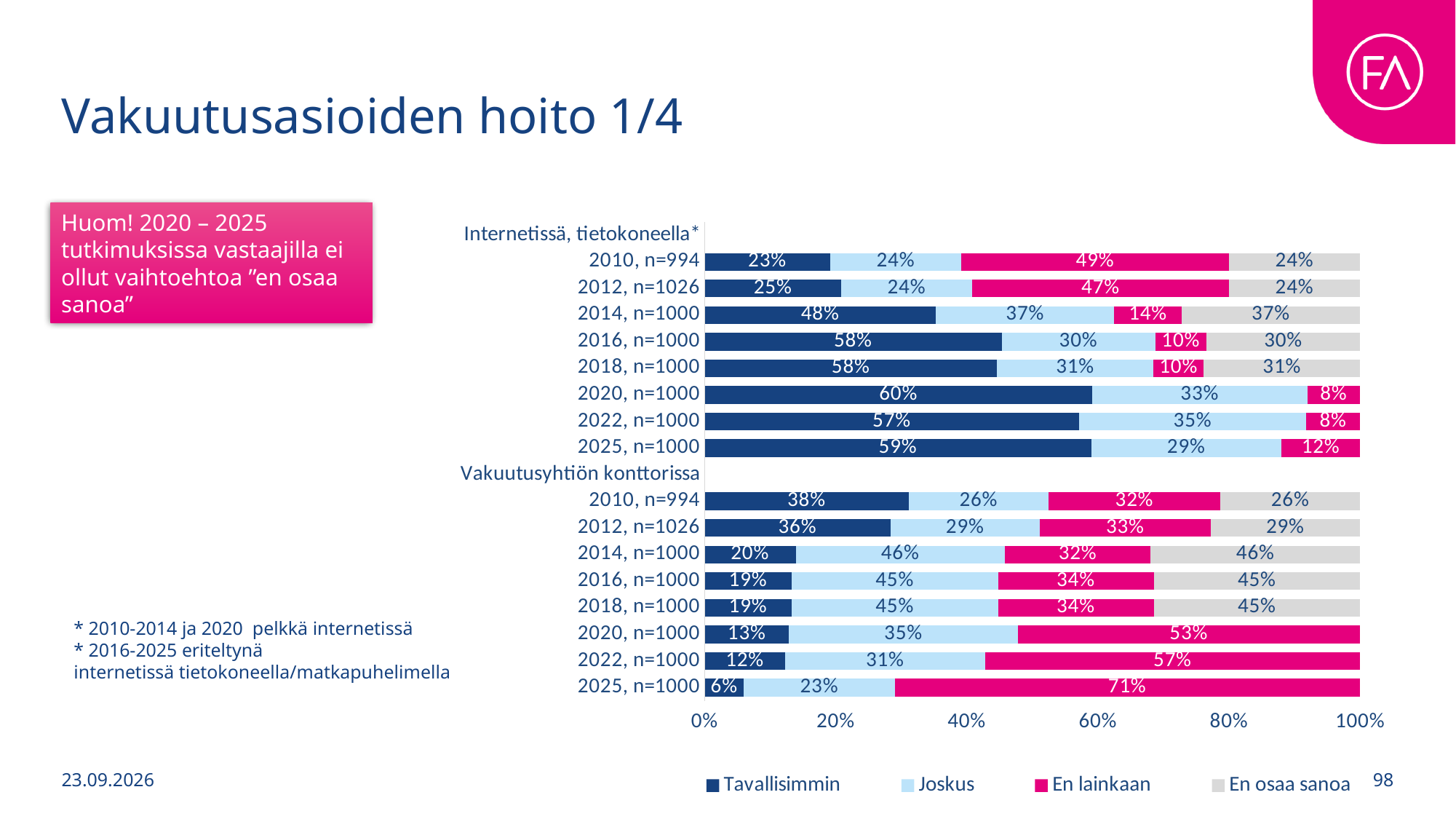
In the 'Vakuutusyhtiön konttorissa' group, which year has the highest 'En lainkaan' value? 2025, n=1000 In the 'Vakuutusyhtiön konttorissa' group, what is the 'Joskus' value for 2014, n=1000? 46% How many year rows are shown under the 'Internetissä, tietokoneella' group? 8 In the 'Vakuutusyhtiön konttorissa' group, does the 'Tavallisimmin' value rise or fall from 2010 to 2025? Fall In the 'Vakuutusyhtiön konttorissa' group, what is the 'En lainkaan' value for 2025, n=1000? 71% What kind of chart is shown on the slide? Stacked bar chart In the 'Internetissä, tietokoneella' group, what is the difference between the 'En lainkaan' value for 2010, n=994 and for 2025, n=1000? 37 percentage points Which colour represents 'En lainkaan' in the legend? Magenta (pink) For 2016, n=1000, which group has the larger 'Tavallisimmin' value: 'Internetissä, tietokoneella' or 'Vakuutusyhtiön konttorissa'? Internetissä, tietokoneella How many series does the legend list? 4 In the 'Internetissä, tietokoneella' group, what is the 'Tavallisimmin' value for 2020, n=1000? 60% In the 'Internetissä, tietokoneella' group, which year has the lowest 'Tavallisimmin' value? 2010, n=994